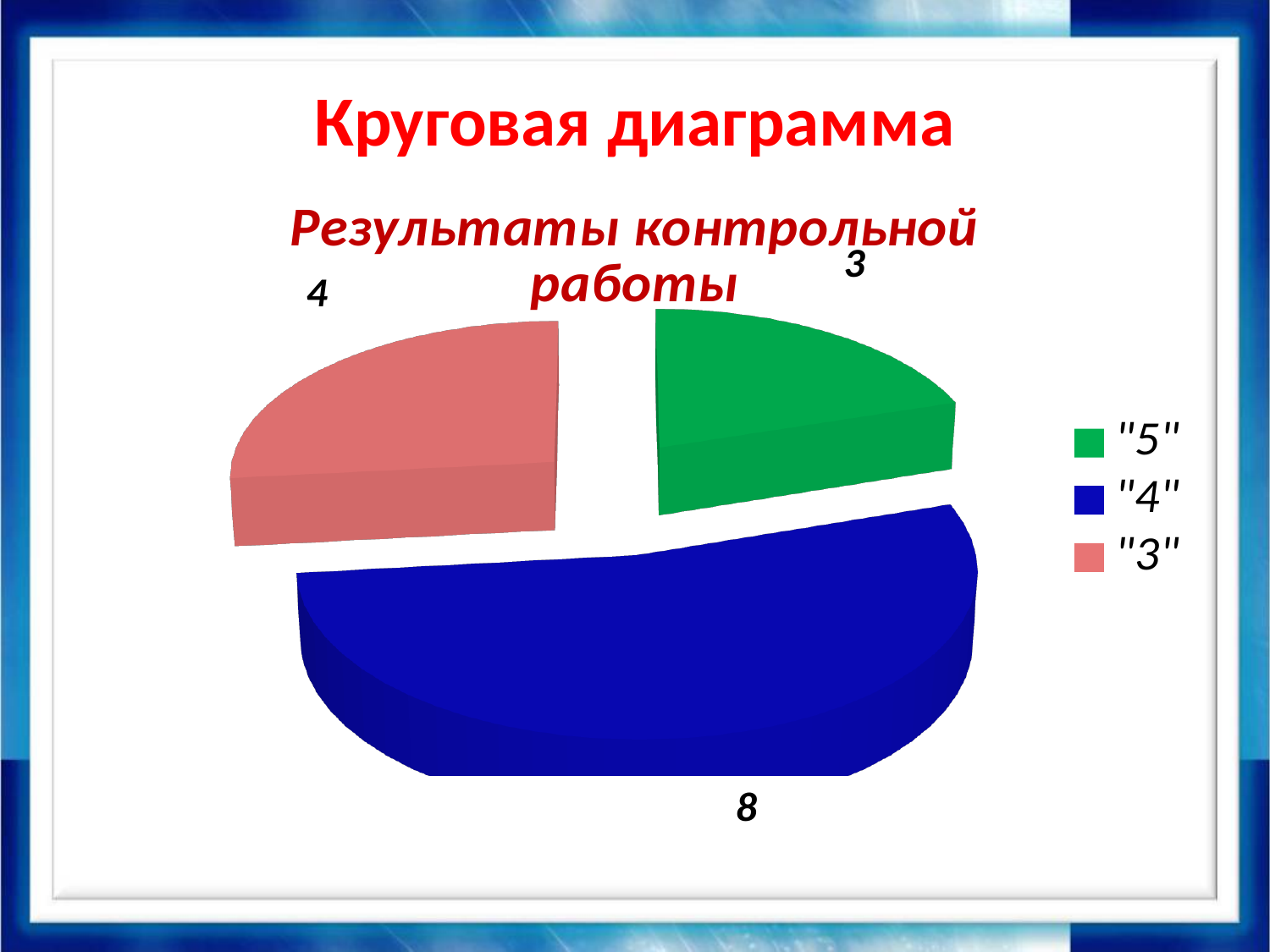
Which grade has the largest slice? "4" What is the total of all slices in the pie chart? 15 Which is larger, the value for "3" or the value for "5"? "3" What kind of chart is shown on the slide? pie chart How many slices does the pie chart have? 3 How many entries does the legend list? 3 What is the value for the "3" slice? 4 What is the title of the chart? Результаты контрольной работы What is the difference between the values for "4" and "3"? 4 Which grade has the smallest slice? "5" What is the value for the "5" slice? 3 What is the value for the "4" slice? 8